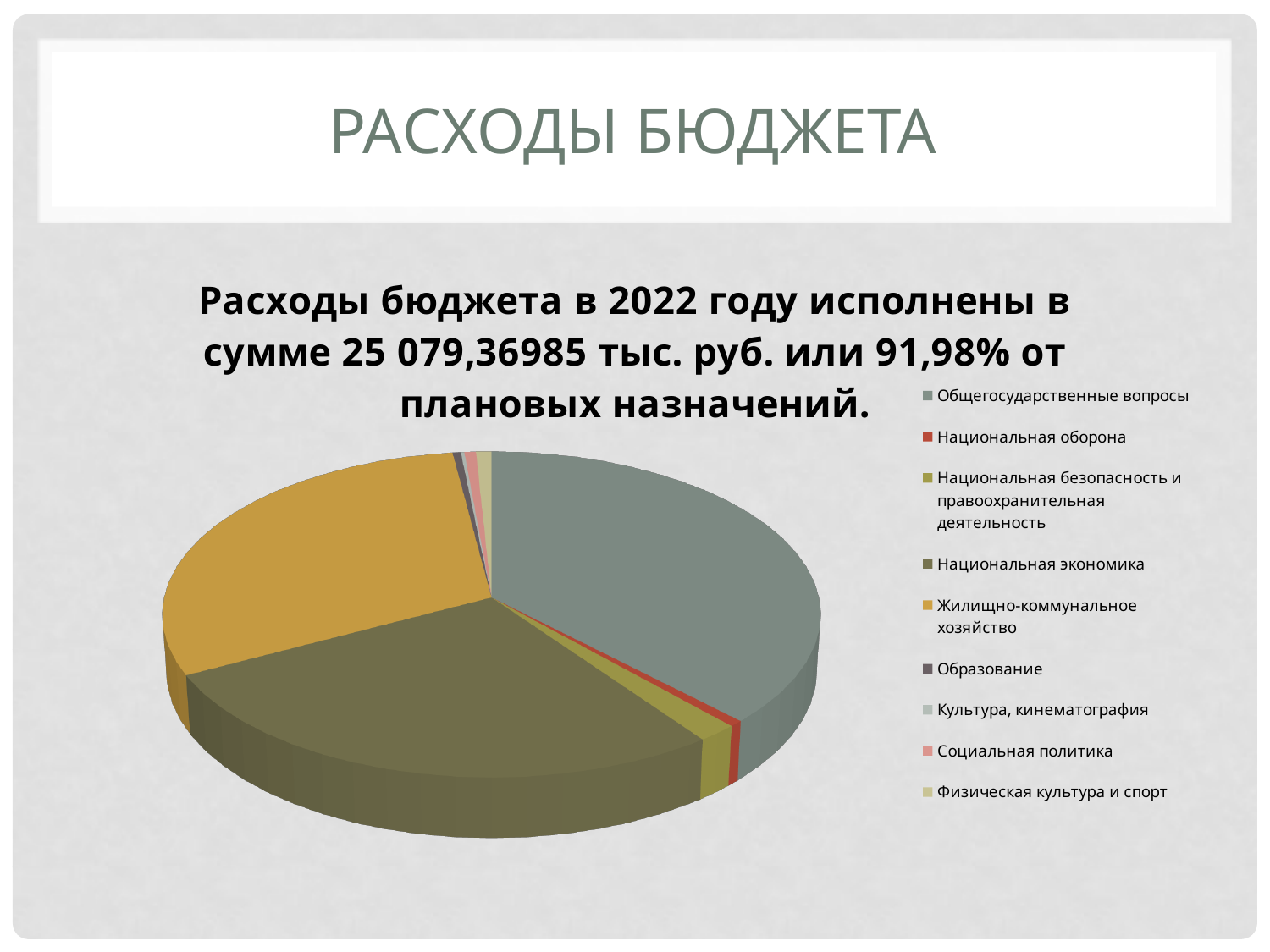
Which slice is larger: Жилищно-коммунальное хозяйство or Социальная политика? Жилищно-коммунальное хозяйство Which slice is larger: Национальная экономика or Национальная безопасность и правоохранительная деятельность? Национальная экономика What kind of chart is shown on the slide? pie chart What is the last category listed in the pie chart legend? Физическая культура и спорт How many categories does the legend of the pie chart list? 9 Which category has the largest slice in the pie chart? Общегосударственные вопросы What colour is used for Национальная оборона in the pie chart legend? red Which slice is larger: Общегосударственные вопросы or Национальная экономика? Общегосударственные вопросы